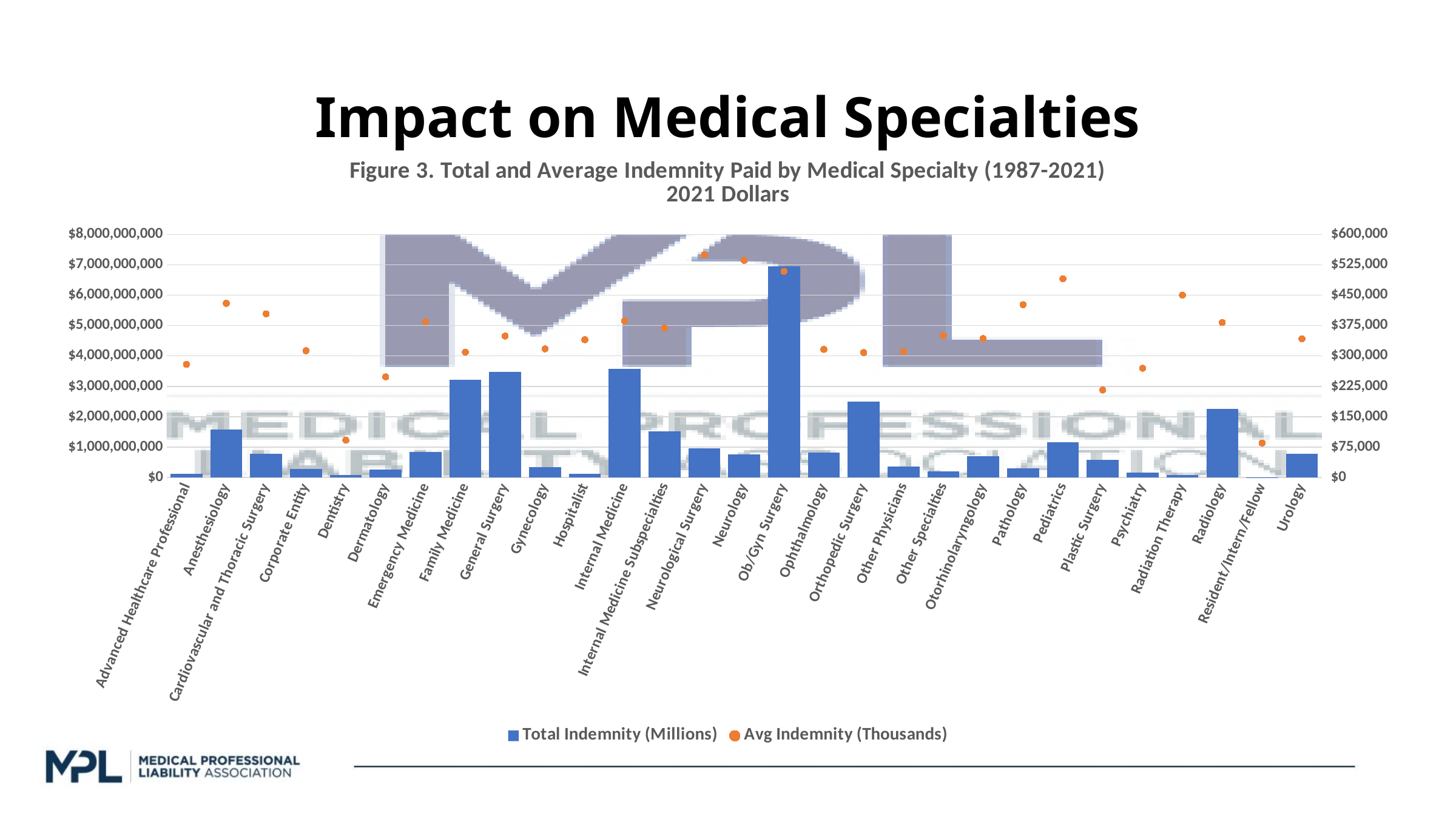
Is the Total Indemnity value for Family Medicine greater or less than $3,000,000,000? greater Which medical specialty has the highest Total Indemnity bar? Ob/Gyn Surgery Is the Total Indemnity value for Anesthesiology greater or less than $2,000,000,000? less Is the Total Indemnity value for Ob/Gyn Surgery greater or less than $6,000,000,000? greater Which medical specialty has the lowest Total Indemnity bar? Resident/Intern/Fellow How many medical specialties are shown on the x axis? 29 How many series does the legend list? 2 Which has the larger Total Indemnity bar, Radiology or Pediatrics? Radiology Which has the larger Total Indemnity bar, Internal Medicine or Orthopedic Surgery? Internal Medicine What is the highest value shown on the right-hand y axis? $600,000